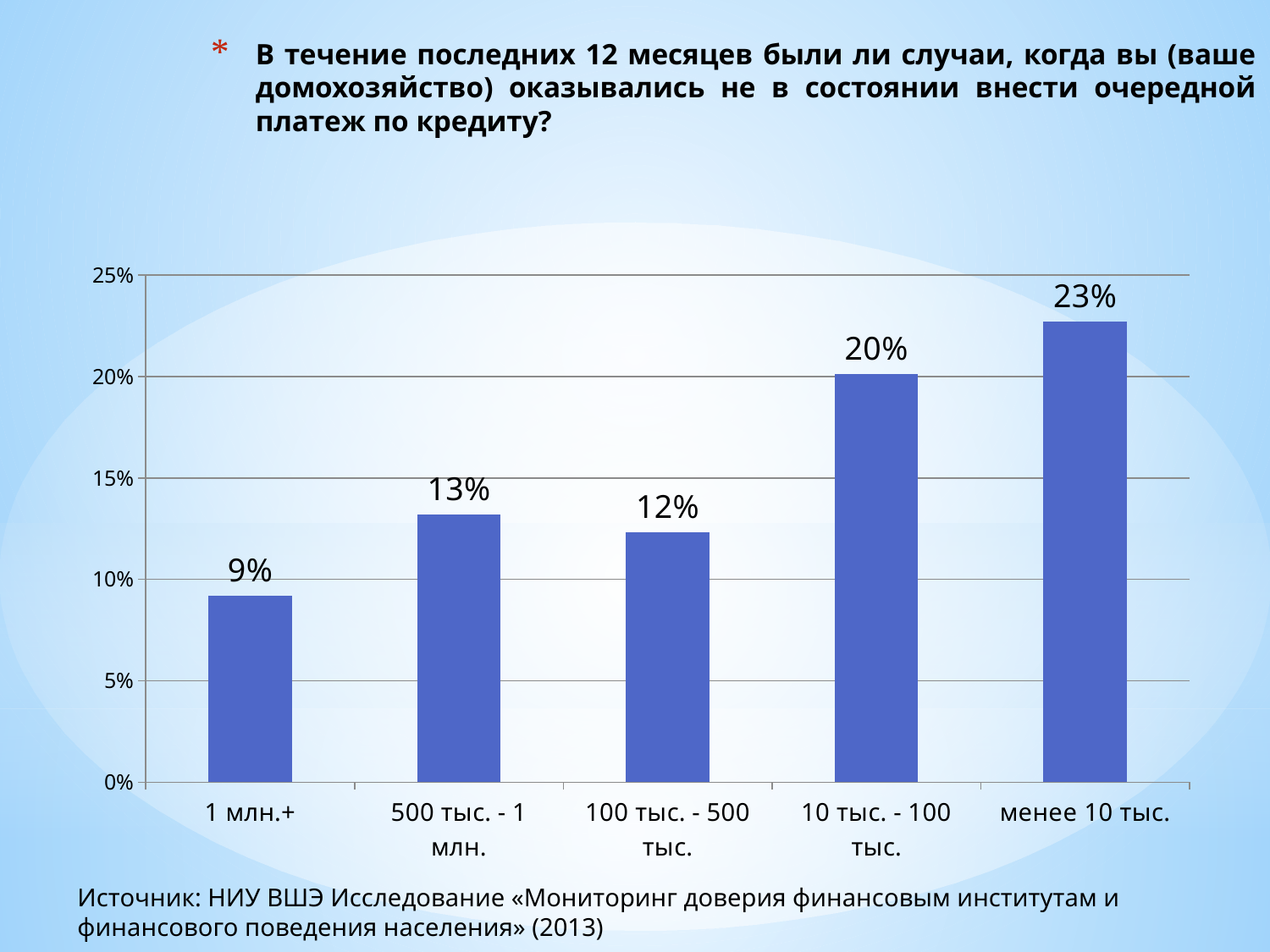
What is the difference between the values for "10 тыс. - 100 тыс." and "500 тыс. - 1 млн."? 7% Which is larger, the value for "500 тыс. - 1 млн." or the value for "100 тыс. - 500 тыс."? 500 тыс. - 1 млн. What is the value for the "менее 10 тыс." category? 23% What kind of chart is shown on the slide? bar chart What is the value for the "100 тыс. - 500 тыс." category? 12% Is the value for "10 тыс. - 100 тыс." greater or less than 15%? greater Which category has the highest value? менее 10 тыс. What is the difference between the values for "менее 10 тыс." and "1 млн.+"? 14% What is the source cited below the chart? НИУ ВШЭ Исследование «Мониторинг доверия финансовым институтам и финансового поведения населения» (2013) What is the value for the "1 млн.+" category? 9% Which category has the lowest value? 1 млн.+ How many categories are shown on the x axis? 5